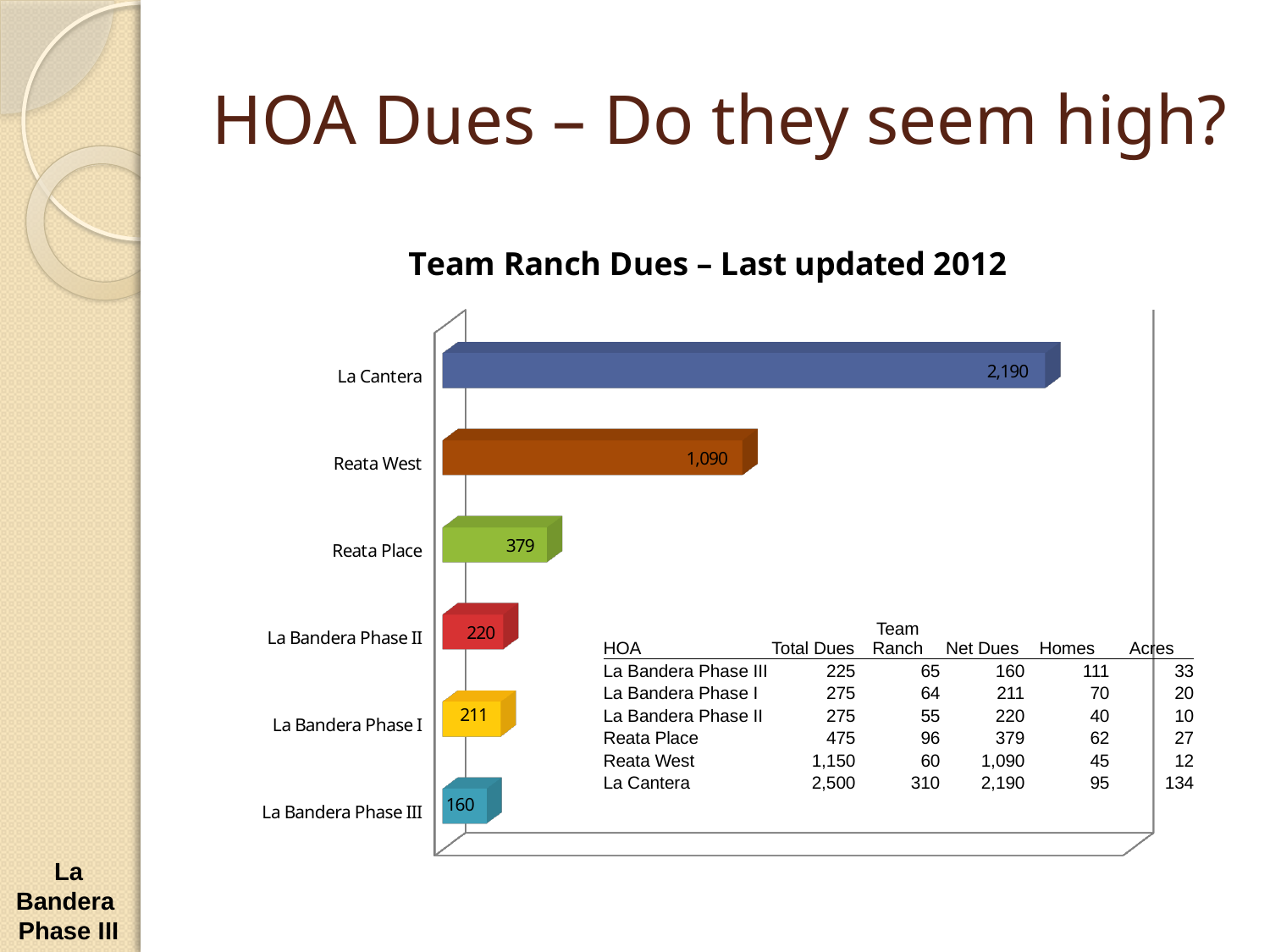
What is the value for La Bandera Phase III in the chart? 160 What is the difference between the values for La Cantera and Reata West? 1,100 What is the value for La Cantera in the chart? 2,190 What kind of chart is shown on the slide? Bar chart What is the difference between the values for La Bandera Phase II and La Bandera Phase I? 9 Which category has the lowest value in the chart? La Bandera Phase III What is the title of the chart? Team Ranch Dues – Last updated 2012 How many categories are shown in the chart? 6 What is the value for Reata West in the chart? 1,090 What is the value for Reata Place in the chart? 379 Which is larger, the value for Reata Place or the value for La Bandera Phase II? Reata Place Which category has the highest value in the chart? La Cantera